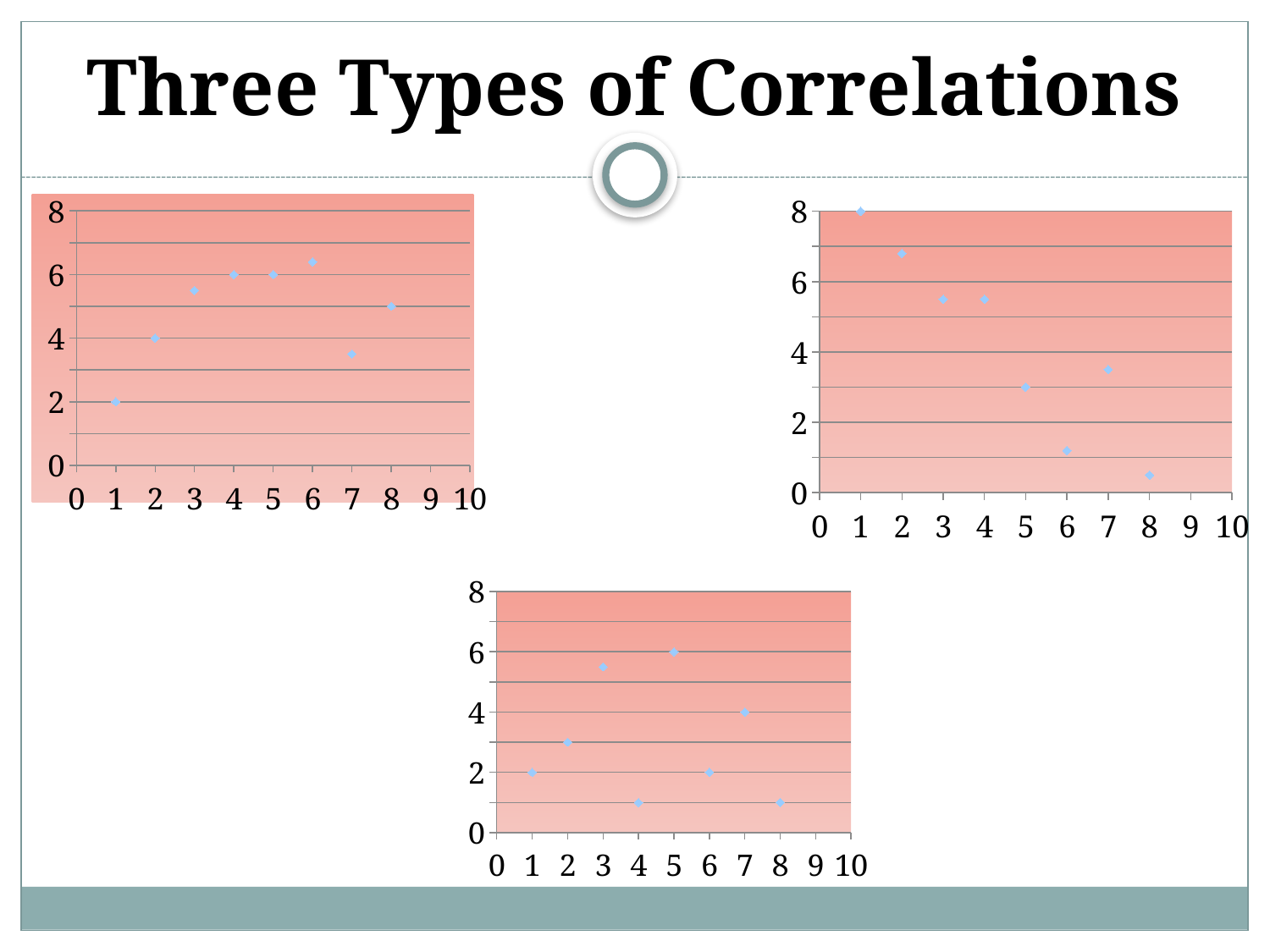
On the bottom chart, which point is higher, the one at x = 3 or the one at x = 4? x = 3 What kind of chart is the top-left chart? scatter chart How many data points are plotted on the top-right chart? 8 On the top-left chart, at which x value is the lowest point? 1 On the top-right chart, do the values generally rise or fall as x increases? fall On the top-left chart, do the values generally rise or fall as x increases from 1 to 6? rise On the bottom chart, is the value at x = 5 greater or less than 4? greater On the top-left chart, what is the y value of the point at x = 1? 2 On the top-right chart, at which x value is the lowest point? 8 On the top-right chart, at which x value is the highest point? 1 On the top-right chart, what is the y value of the point at x = 1? 8 On the top-right chart, is the value at x = 8 greater or less than 2? less